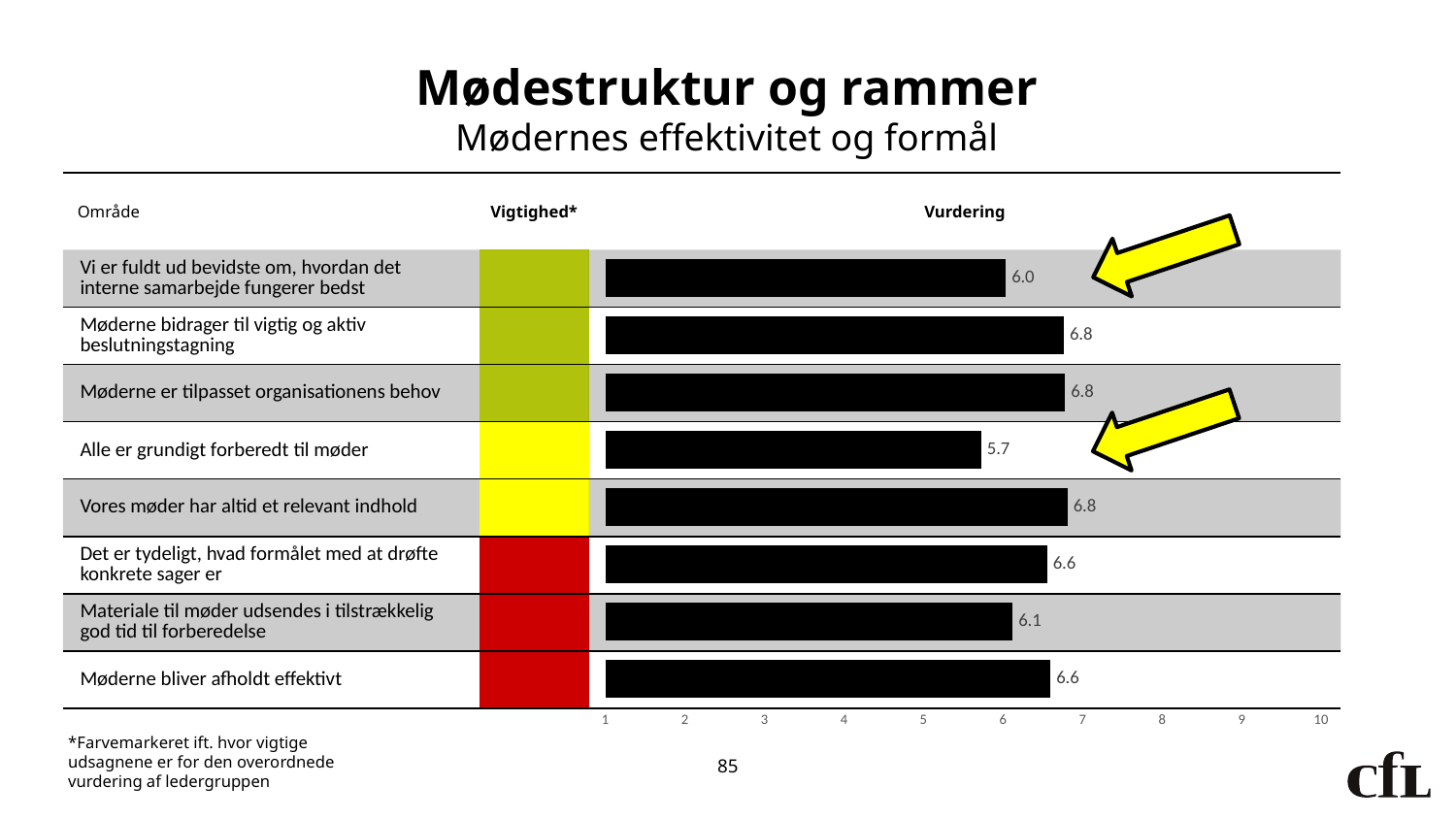
What is the Vurdering value for "Møderne bliver afholdt effektivt"? 6.6 What is the Vurdering value for "Vi er fuldt ud bevidste om, hvordan det interne samarbejde fungerer bedst"? 6.0 Which has a higher Vurdering value: "Det er tydeligt, hvad formålet med at drøfte konkrete sager er" or "Materiale til møder udsendes i tilstrækkelig god tid til forberedelse"? Det er tydeligt, hvad formålet med at drøfte konkrete sager er What is the Vurdering value for "Alle er grundigt forberedt til møder"? 5.7 What kind of chart is used to show the Vurdering values? Bar chart How many areas (bars) are shown in the chart? 8 What is the highest Vurdering value shown on the chart? 6.8 Which area has the lowest Vurdering value? Alle er grundigt forberedt til møder What is the difference between the Vurdering values for "Møderne er tilpasset organisationens behov" and "Alle er grundigt forberedt til møder"? 1.1 Is the Vurdering value for "Vores møder har altid et relevant indhold" greater or less than 6? greater What is the Vurdering value for "Materiale til møder udsendes i tilstrækkelig god tid til forberedelse"? 6.1 What is the maximum value shown on the chart's horizontal axis? 10